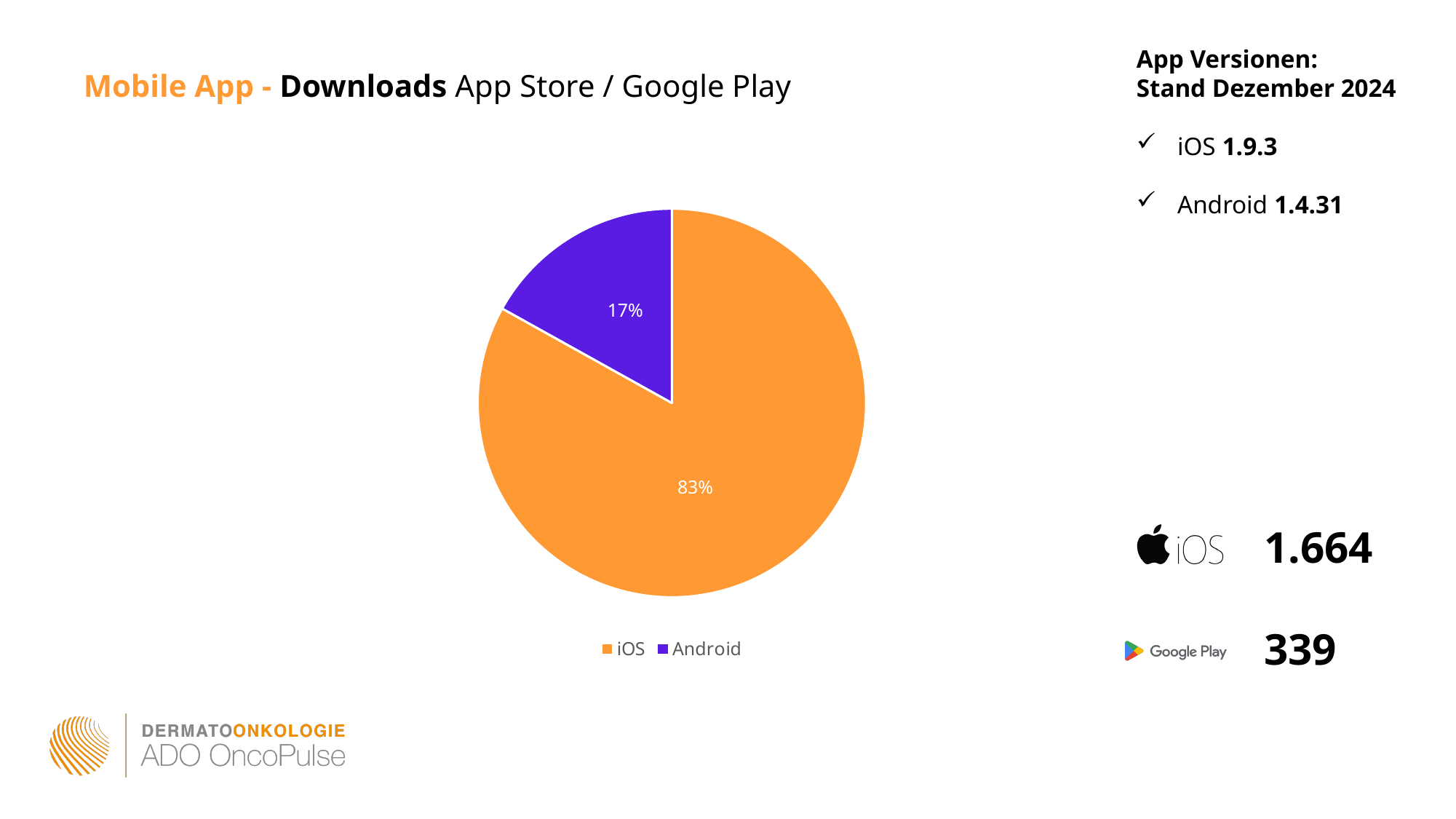
How many entries does the legend list? 2 Which is larger, the iOS slice or the Android slice? iOS What is the difference in percentage points between the iOS and Android slices? 66 Which slice of the pie is the largest? iOS What colour is the Android slice? purple What kind of chart is shown on the slide? pie chart How many slices does the pie chart have? 2 Which slice of the pie is the smallest? Android What share of the pie does Android have? 17% What colour is the iOS slice? orange What share of the pie does iOS have? 83%